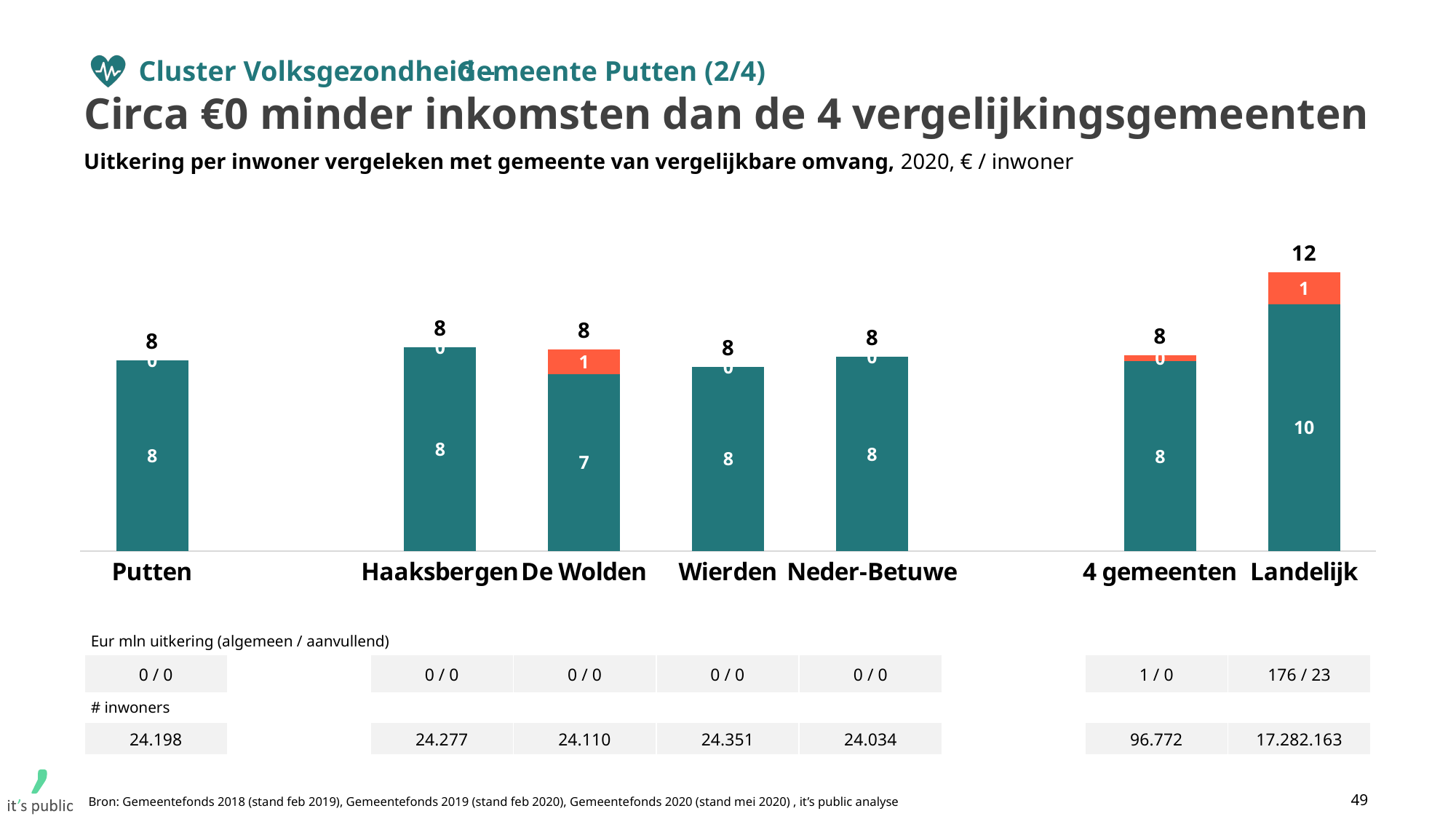
How many categories (bars) are shown on the x axis of the chart? 7 What unit is stated in the chart subtitle for the values shown? € / inwoner What is the value of the orange (upper) segment of the De Wolden bar? 1 Which category has the highest total value in the chart? Landelijk What is the value of the orange (upper) segment of the Landelijk bar? 1 What kind of chart is shown on the slide? Stacked bar chart What is the value of the teal (lower) segment of the De Wolden bar? 7 What is the value of the teal (lower) segment of the Landelijk bar? 10 Which has a larger total value: Landelijk or 4 gemeenten? Landelijk What is the total value labelled above the bar for Landelijk? 12 What is the difference between the total labelled for Landelijk and the total labelled for Putten? 4 What is the total value labelled above the bar for Putten? 8